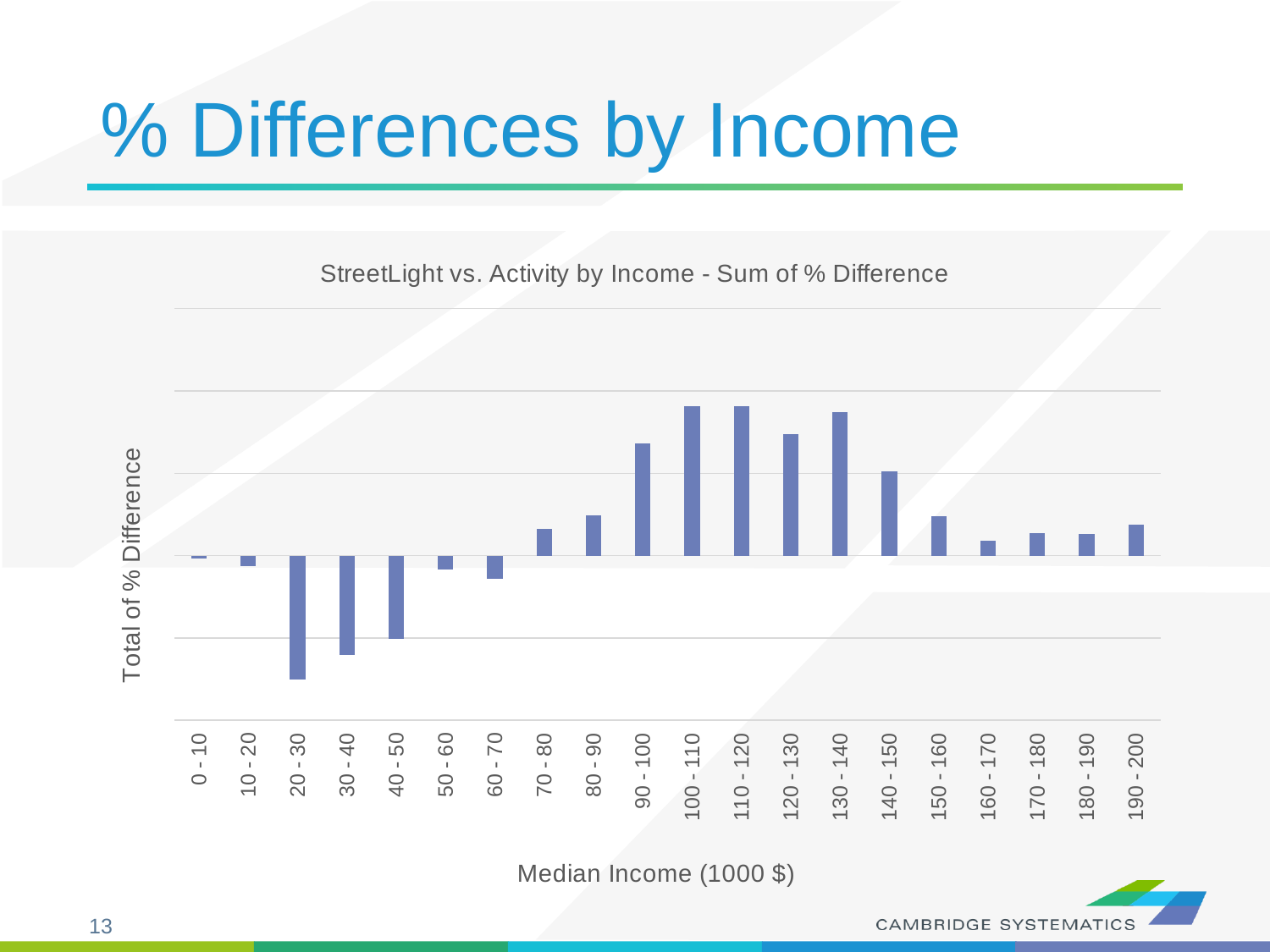
Do the values rise or fall along the x axis from 20 - 30 to 100 - 110? rise Which is larger, the value for 90 - 100 or the value for 80 - 90? 90 - 100 Which income category has the lowest (most negative) value? 20 - 30 What is the x-axis title of the chart? Median Income (1000 $) What is the title of the chart? StreetLight vs. Activity by Income - Sum of % Difference Which is larger, the value for 140 - 150 or the value for 150 - 160? 140 - 150 Which is larger, the value for 20 - 30 or the value for 40 - 50? 40 - 50 Do the values rise or fall along the x axis from 130 - 140 to 160 - 170? fall What kind of chart is shown on the slide? bar chart How many income categories are plotted along the x axis? 20